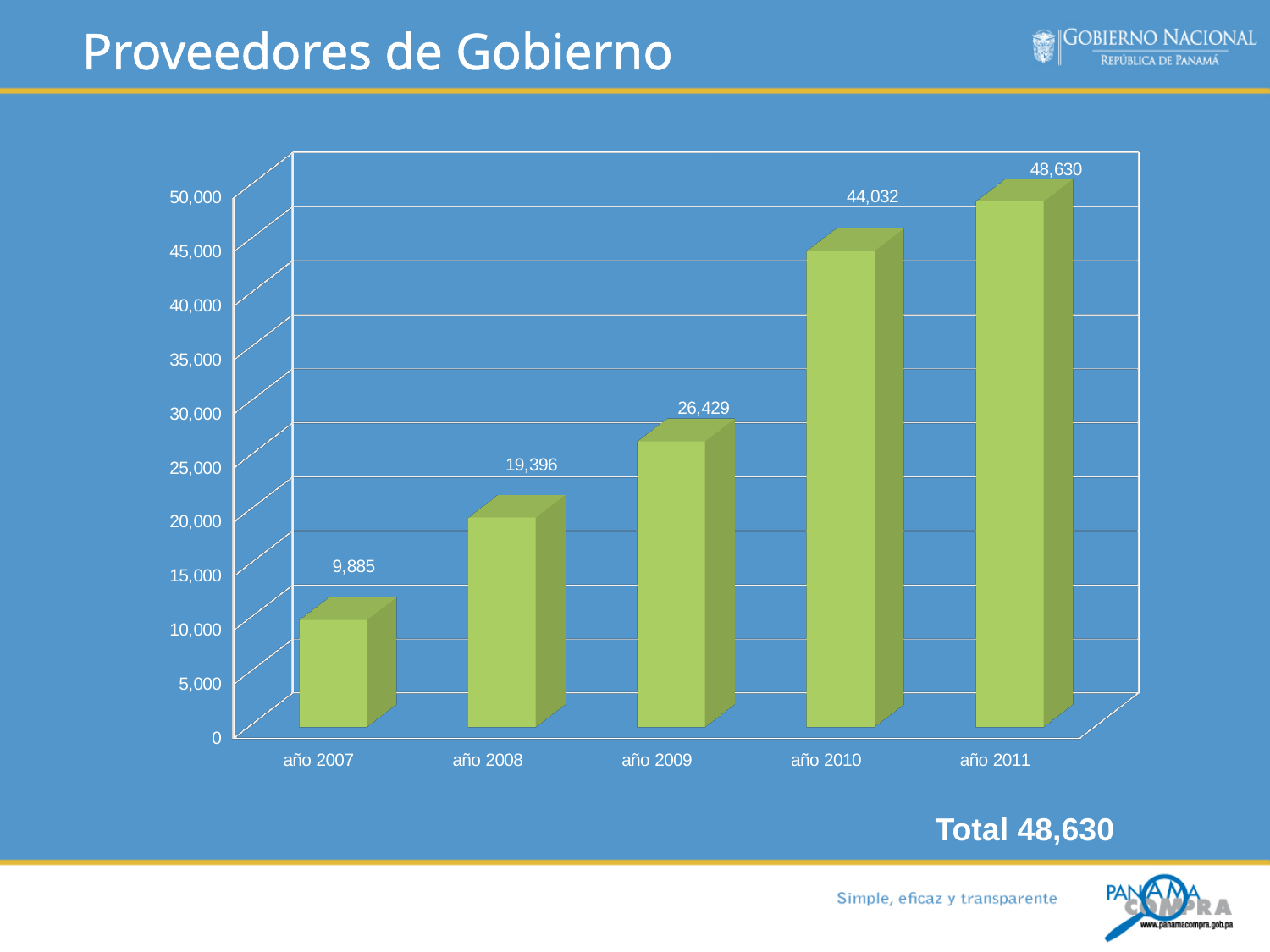
Which year has the lowest value? año 2007 What is the value for año 2009? 26,429 Which year has the highest value? año 2011 What kind of chart is shown on the slide? bar chart Do the values rise or fall from año 2007 to año 2011? rise What is the value for año 2007? 9,885 What is the difference between the values for año 2008 and año 2007? 9,511 What is the difference between the values for año 2011 and año 2010? 4,598 What is the value for año 2010? 44,032 Which is larger, the value for año 2009 or the value for año 2008? año 2009 How many years are shown on the x axis? 5 Is the value for año 2010 greater or less than 40,000? greater